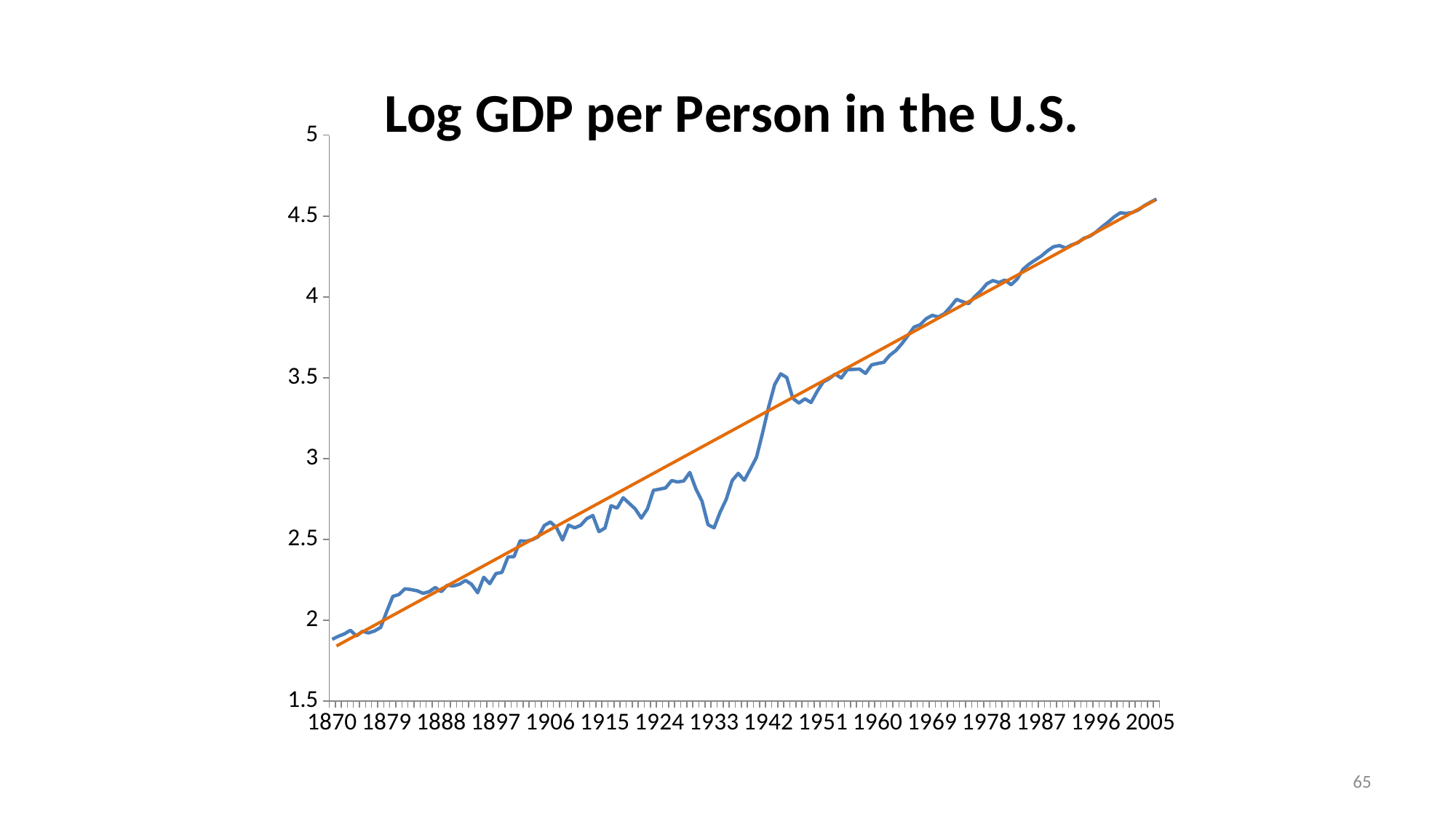
Which year on the x axis has the lowest value of the blue line? 1870 Is the value of the blue line in 1933 larger or smaller than its value in 1942? smaller Is the value of the blue line in 1870 greater or less than 2? less Is the value of the blue line in 1987 greater or less than 4? greater Which year on the x axis has the highest value of the blue line? 2005 How many lines are plotted on the chart? 2 Is the value of the blue line in 1924 greater or less than 3? less Do the values of the blue line generally rise or fall from 1870 to 2005? rise What kind of chart is shown on the slide? line chart What is the title of the chart? Log GDP per Person in the U.S.